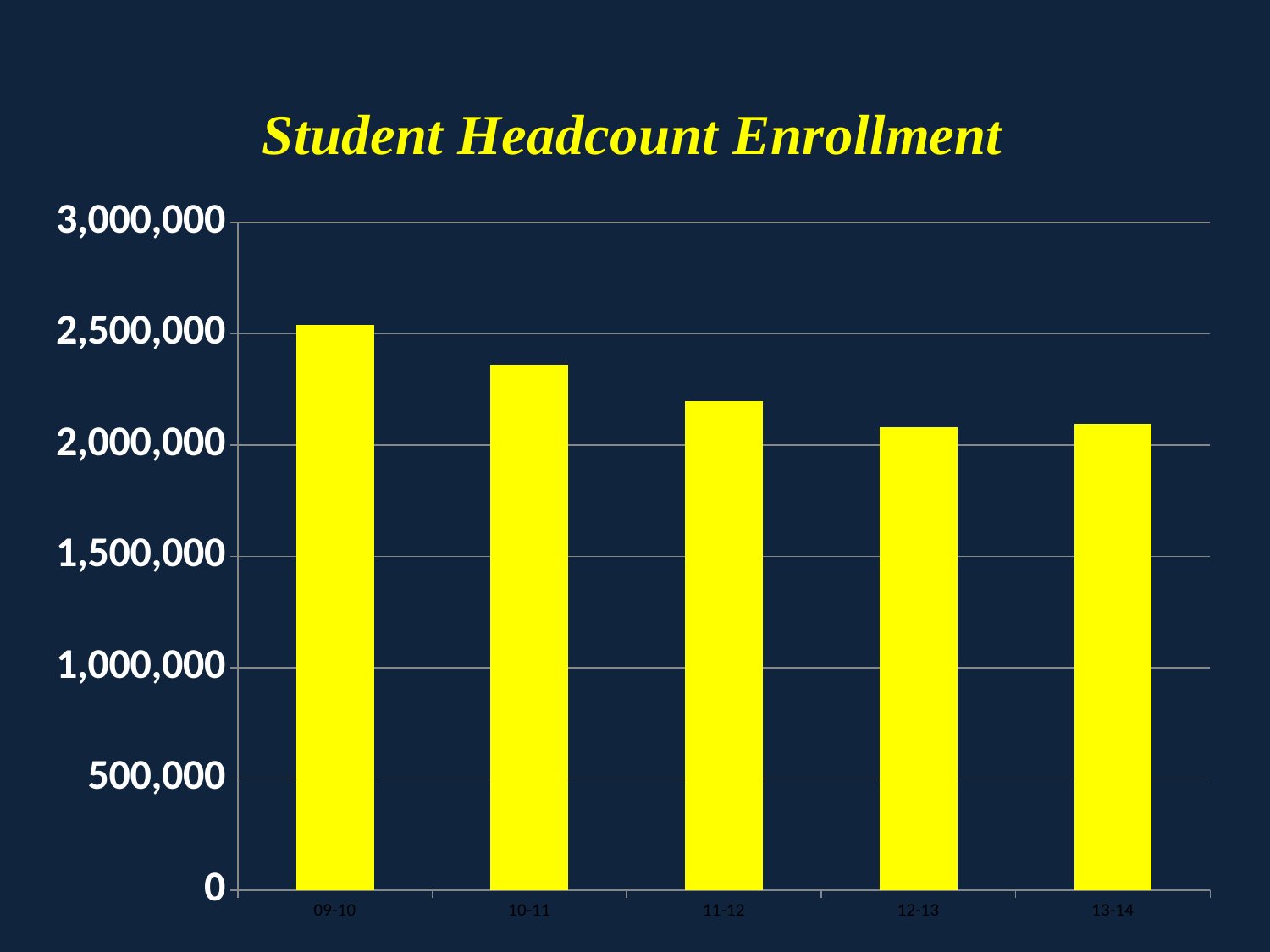
Is the value for 13-14 greater or less than 2,500,000? less What is the title of the chart? Student Headcount Enrollment Which academic year has the highest student headcount enrollment? 09-10 Is the value for 10-11 greater or less than 2,500,000? less Do the enrollment values generally rise or fall from 09-10 to 13-14? fall What colour are the bars in the chart? yellow Which is larger, the enrollment for 09-10 or for 10-11? 09-10 Is the value for 09-10 greater or less than 2,000,000? greater Which is larger, the enrollment for 11-12 or for 12-13? 11-12 What kind of chart is shown on the slide? bar chart How many academic years are shown on the x axis? 5